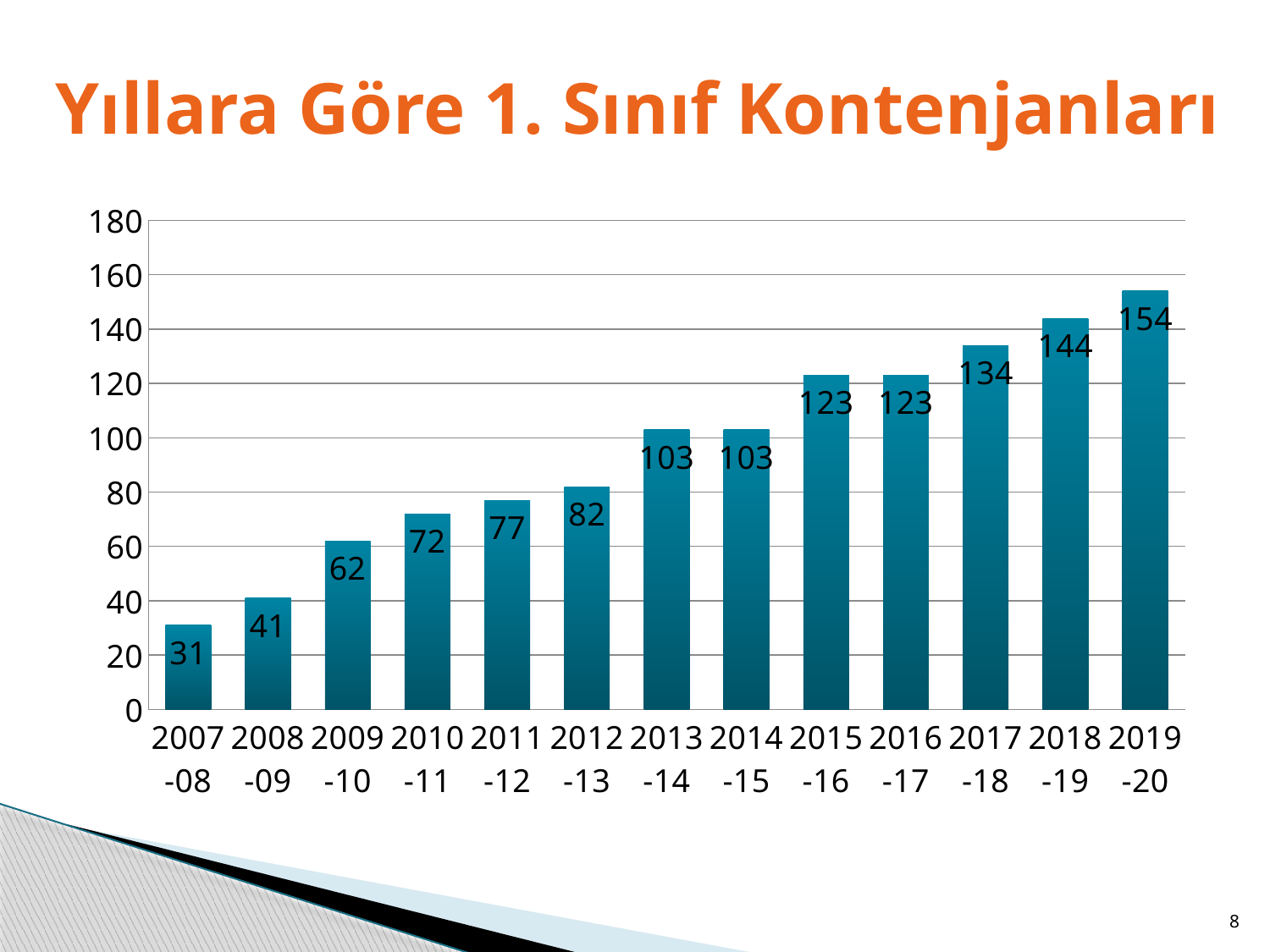
Do the values generally rise or fall from 2007-08 to 2019-20? rise What is the value for 2007-08? 31 Which year has the lowest value? 2007-08 What is the difference between the values for 2009-10 and 2008-09? 21 Which is larger, the value for 2010-11 or the value for 2013-14? 2013-14 What is the difference between the values for 2019-20 and 2018-19? 10 What is the value for 2015-16? 123 What kind of chart is shown on the slide? bar chart How many years are shown on the x axis? 13 Is the value for 2017-18 greater or less than 120? greater What is the value for 2012-13? 82 Which year has the highest value? 2019-20